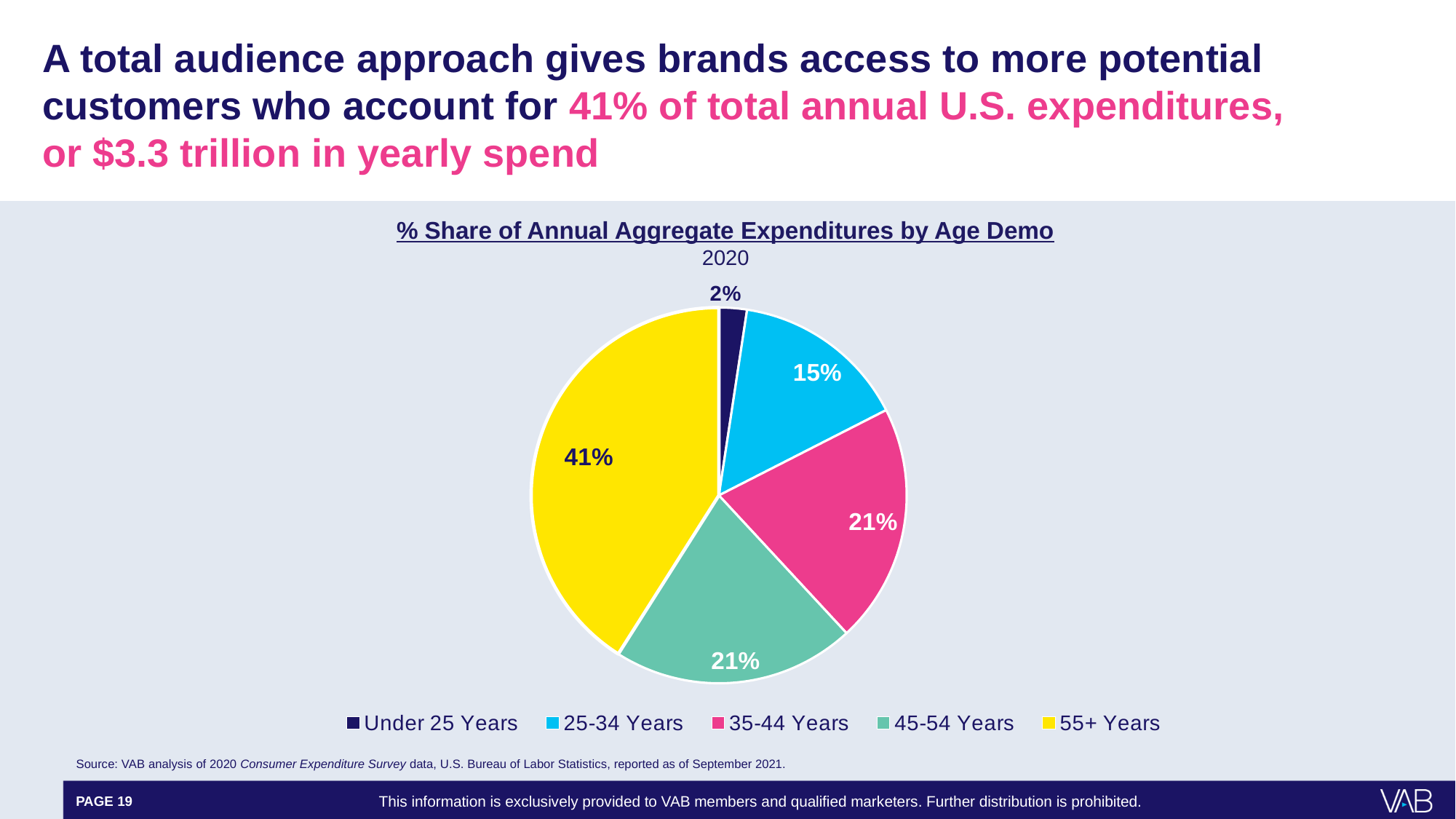
Which has a larger share, the 25-34 Years group or the 45-54 Years group? 45-54 Years What share of annual aggregate expenditures is attributed to the Under 25 Years group? 2% Which age group has the largest share of annual aggregate expenditures? 55+ Years What type of chart is shown on the slide? Pie chart What is the title of the chart? % Share of Annual Aggregate Expenditures by Age Demo What share of annual aggregate expenditures is attributed to the 25-34 Years group? 15% What share of annual aggregate expenditures is attributed to the 35-44 Years group? 21% What year does the chart's data refer to? 2020 How many age groups are shown in the pie chart? 5 What is the difference in share between the 55+ Years group and the 25-34 Years group? 26 percentage points Which age group has the smallest share of annual aggregate expenditures? Under 25 Years What share of annual aggregate expenditures is attributed to the 55+ Years group? 41%